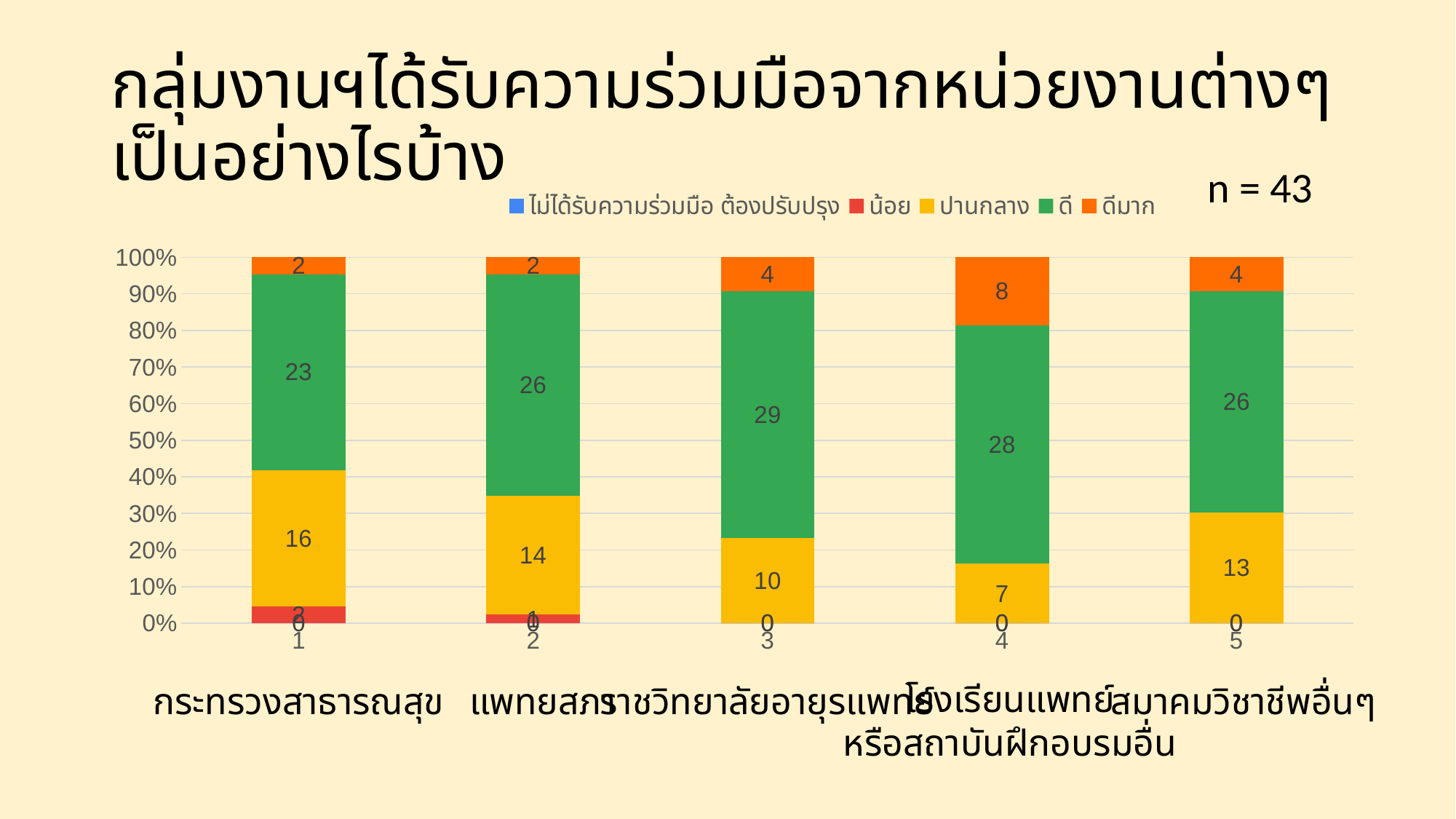
What is the value of the ดี (green) segment for category 3? 29 Which category on the x axis has the lowest ปานกลาง (yellow) value? 4 How many categories are shown on the x axis? 5 Which category on the x axis has the highest ดีมาก (orange) value? 4 Which has the larger ปานกลาง (yellow) value, category 1 or category 5? Category 1 What is the value of the ดี (green) segment for category 1? 23 Which category on the x axis has the highest ดี (green) value? 3 What is the value of the ปานกลาง (yellow) segment for category 4? 7 What is the difference between the ดี (green) values for category 3 and category 1? 6 What type of chart is shown on the slide? Stacked bar chart How many series does the legend list? 5 What is the value of the ดีมาก (orange) segment for category 4? 8